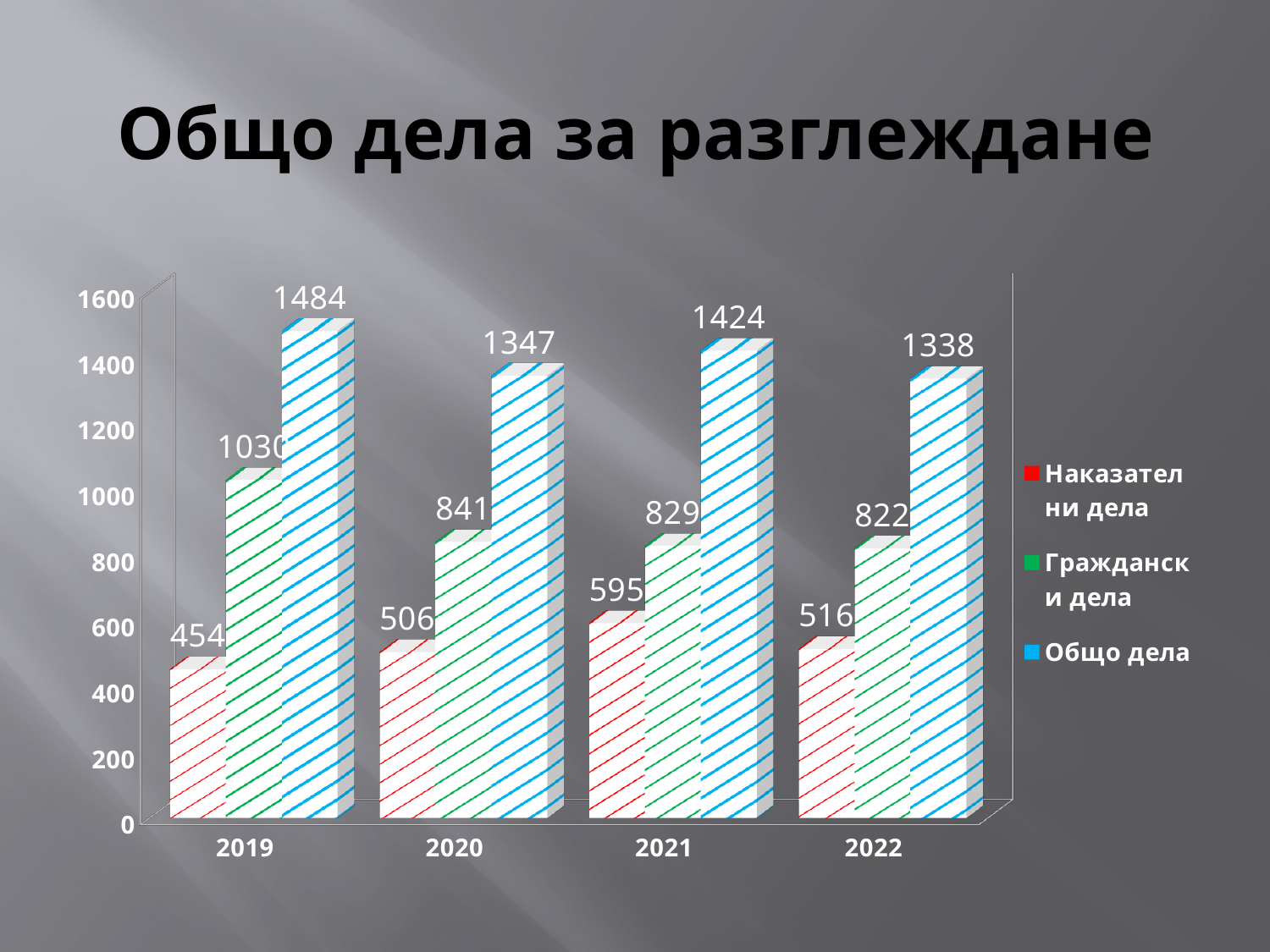
What is the difference between Общо дела in 2019 and in 2020? 137 What is the difference between Граждански дела and Наказателни дела in 2022? 306 How many series does the legend list? 3 Which is larger: Наказателни дела in 2021 or Наказателни дела in 2022? 2021 What is the title of the chart? Общо дела за разглеждане What is the value for Общо дела in 2022? 1338 What kind of chart is shown on the slide? bar chart What is the value for Наказателни дела in 2021? 595 What is the value for Граждански дела in 2019? 1030 In which year is Наказателни дела lowest? 2019 In which year is Общо дела highest? 2019 How many years are shown on the x axis? 4